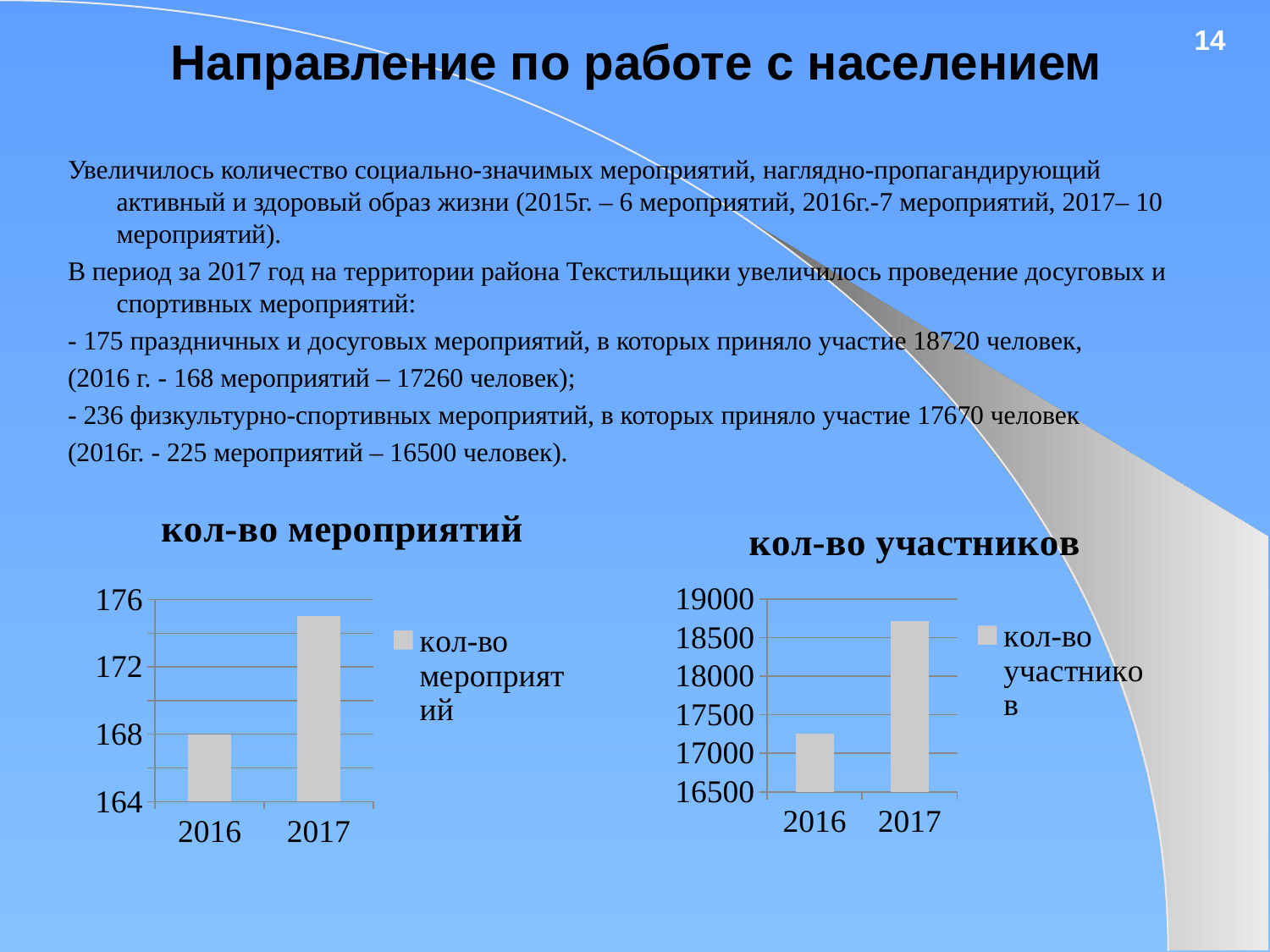
In the "кол-во участников" chart, is the value for 2016 greater or less than 17500? less What is the title of the chart on the right side of the slide? кол-во участников In the "кол-во участников" chart, is the value for 2017 greater or less than 18500? greater In the "кол-во участников" chart, do the values rise or fall from 2016 to 2017? rise In the "кол-во мероприятий" chart, what is the value for 2016? 168 How many categories are shown on the x axis of the "кол-во мероприятий" chart? 2 What is the legend entry in the "кол-во мероприятий" chart? кол-во мероприятий What kind of chart is the "кол-во мероприятий" chart? bar chart In the "кол-во мероприятий" chart, which year has the higher value? 2017 In the "кол-во участников" chart, which year has the lower value? 2016 How many series does the legend of the "кол-во участников" chart list? 1 In the "кол-во мероприятий" chart, is the value for 2017 greater or less than 172? greater